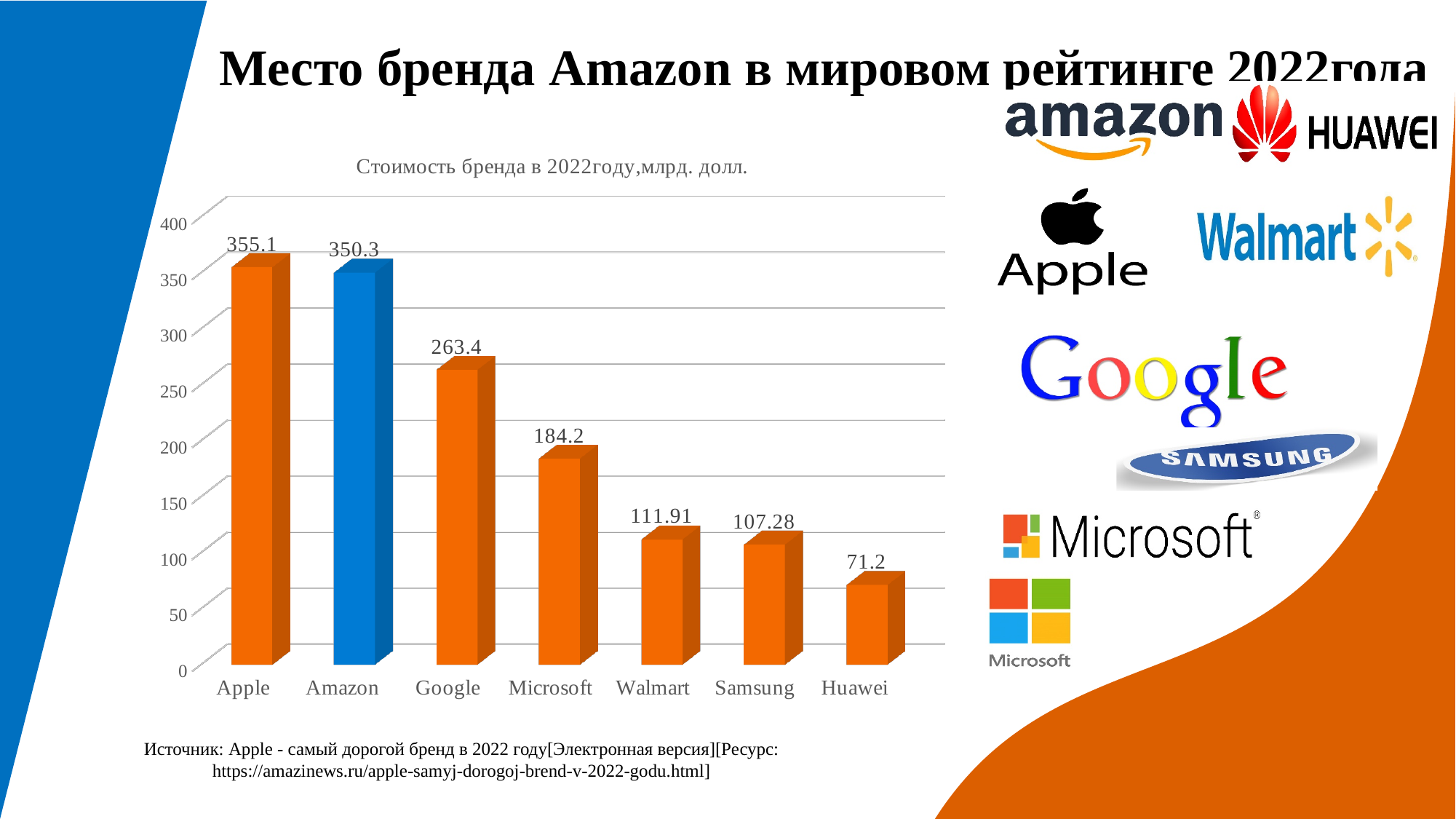
What is the brand value shown for Huawei? 71.2 Which brand has the lowest value in the chart? Huawei What type of chart is shown on the slide? Bar chart What is the difference between the values for Apple and Amazon? 4.8 What is the brand value shown for Walmart? 111.91 Which has a larger value, Walmart or Samsung? Walmart What is the brand value shown for Google? 263.4 What is the difference between the values for Google and Microsoft? 79.2 Do the values rise or fall from left to right along the x axis? Fall Which brand has the highest value in the chart? Apple What is the brand value shown for Amazon? 350.3 How many brands are shown in the chart? 7